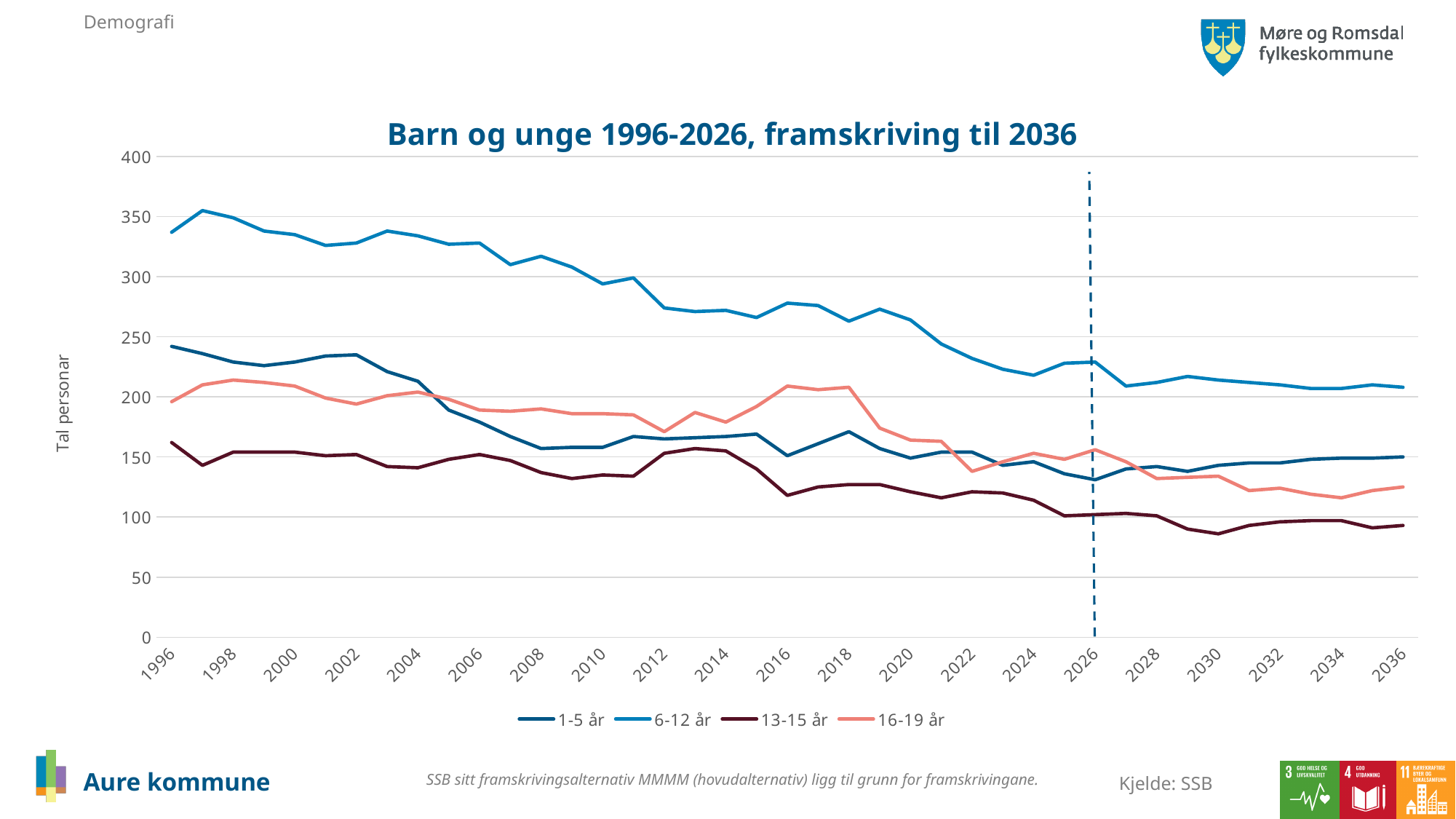
Is the value for 13-15 år in 2016 greater or less than 150? less Does the 6-12 år series generally rise or fall from 1996 to 2036? fall What is the title of the chart? Barn og unge 1996-2026, framskriving til 2036 Is the value for 1-5 år in 1996 greater or less than 200? greater Which series has the highest value in 1996? 6-12 år Is the value for 6-12 år in 1996 greater or less than 300? greater What is the label on the vertical axis? Tal personar Which series has the lowest value in 2036? 13-15 år How many series does the legend list? 4 In 2010, which series has the larger value, 6-12 år or 1-5 år? 6-12 år What kind of chart is shown on the slide? line chart